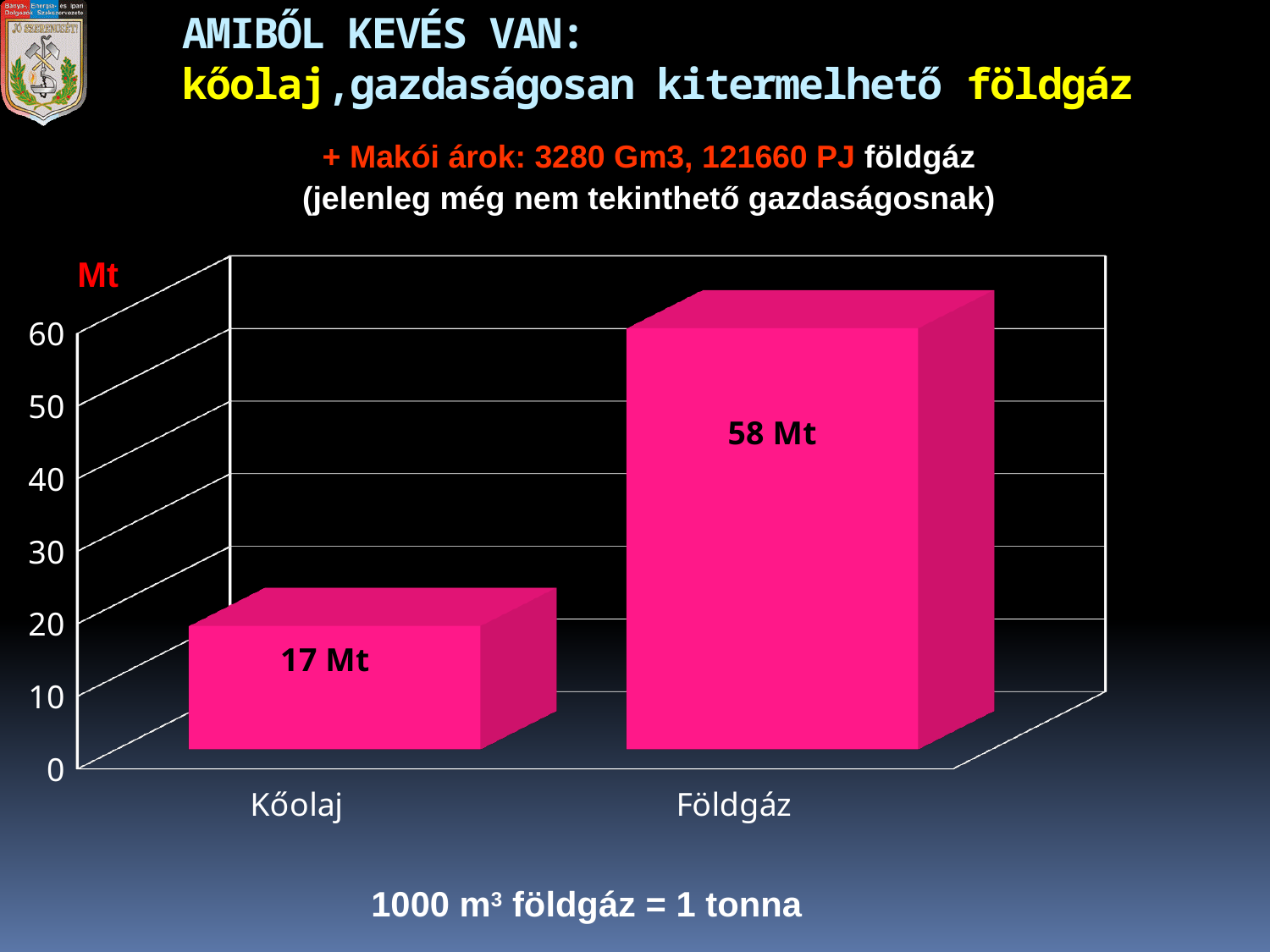
Which category has the lowest value? Kőolaj How many categories are shown on the chart? 2 What is the value for Kőolaj? 17 Mt What kind of chart is shown on the slide? bar chart What unit is shown on the vertical axis of the chart? Mt Is the value for Kőolaj greater or less than 20? less What is the difference between the values for Földgáz and Kőolaj? 41 Mt What colour are the bars in the chart? pink What is the value for Földgáz? 58 Mt Is the value for Földgáz greater or less than 50? greater Which category has the highest value? Földgáz Which is larger, the value for Kőolaj or the value for Földgáz? Földgáz